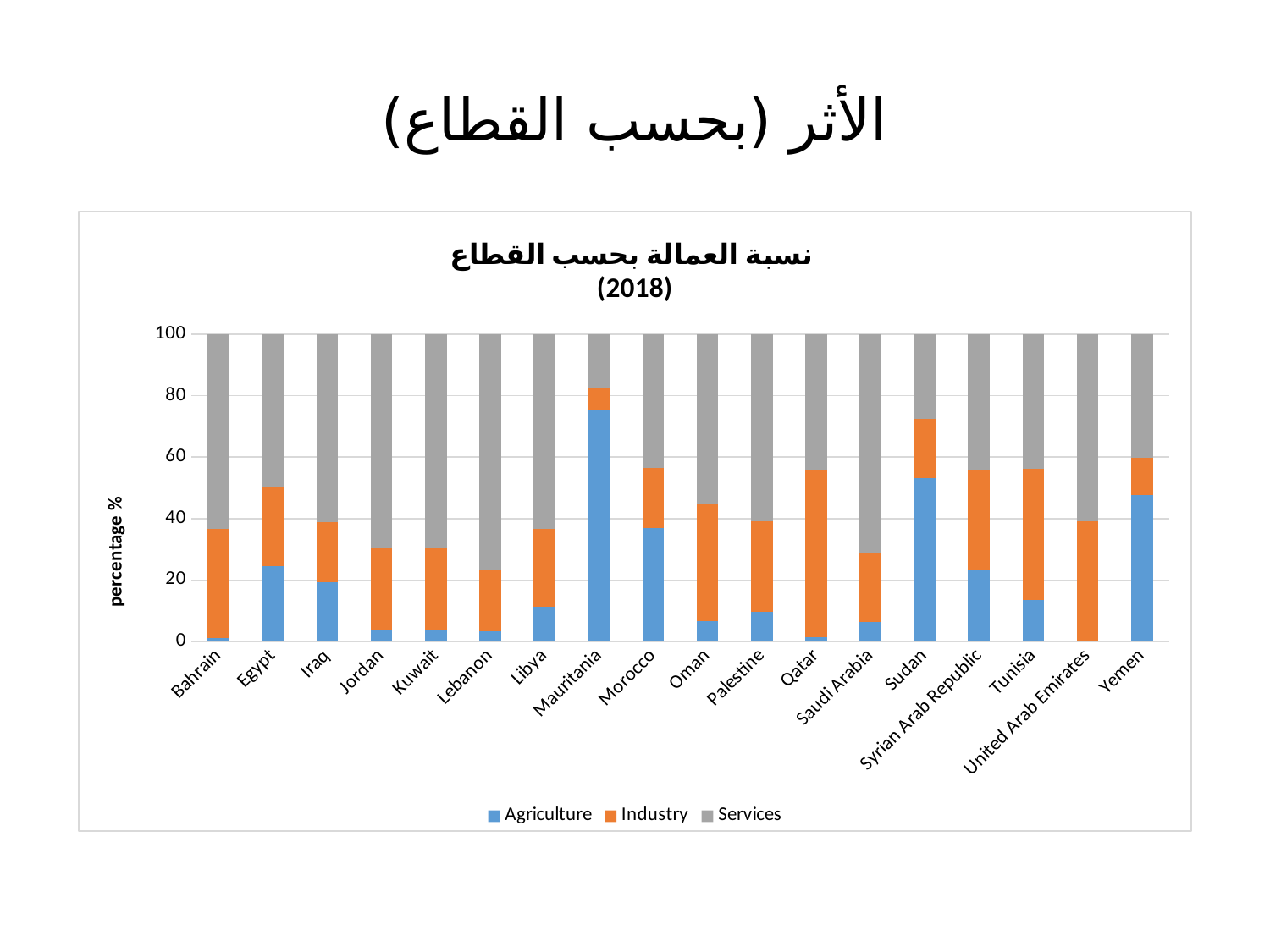
Is the Agriculture value for Egypt greater or less than 40? less How many countries are shown on the x axis of the chart? 18 Is the Agriculture value for Mauritania greater or less than 60? greater How many series does the chart legend list? 3 Which has a larger Agriculture share, Mauritania or Sudan? Mauritania Which colour represents the Services series in the chart? Grey Is the Agriculture value for Sudan greater or less than 40? greater What is the total of the stacked bar for Jordan? 100 What year is given in the chart title? 2018 Which country has the highest Agriculture share in the chart? Mauritania What kind of chart is shown on the slide? Stacked bar chart